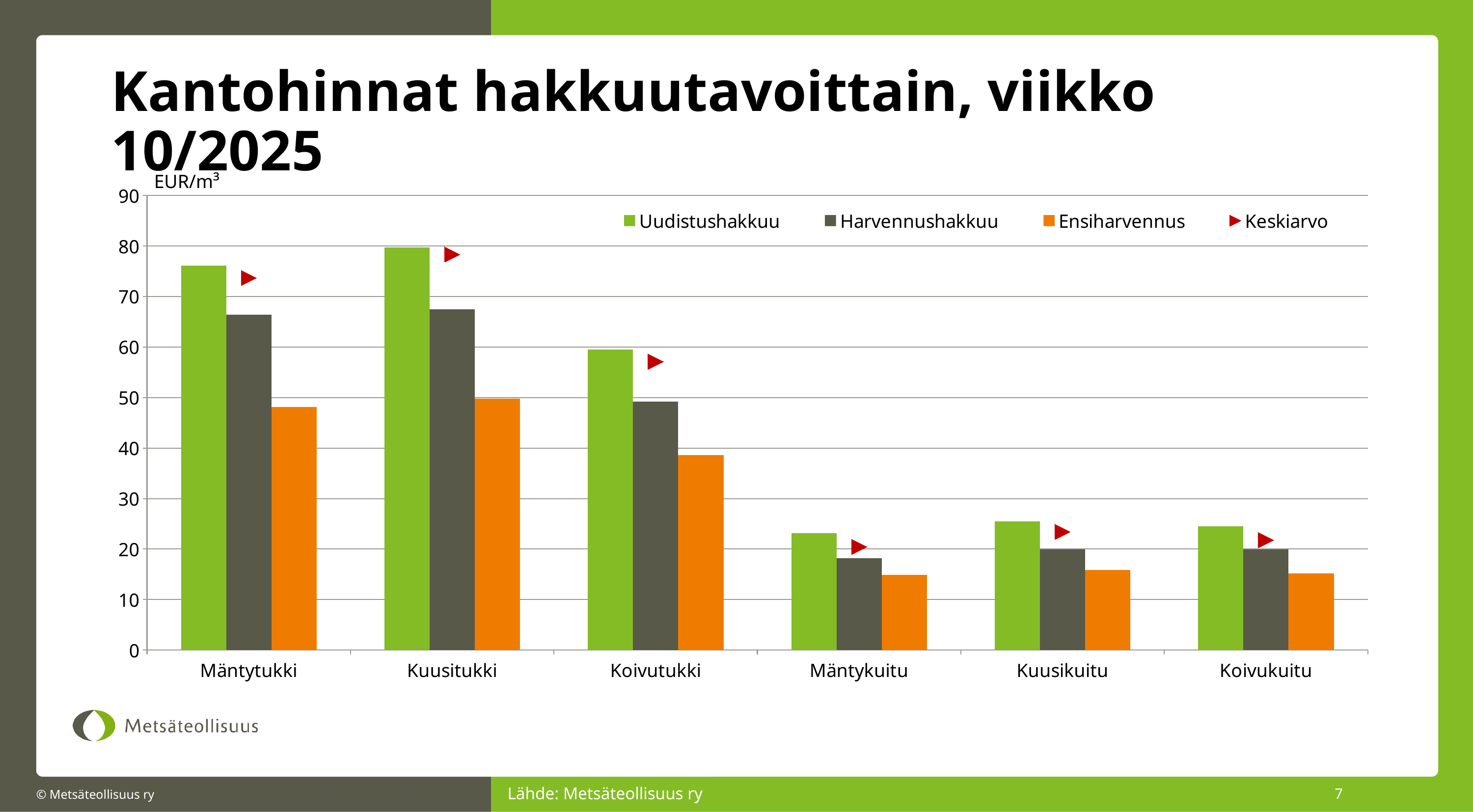
Is the Uudistushakkuu value for Mäntytukki greater or less than 70? greater Is the Harvennushakkuu value for Kuusitukki greater or less than 60? greater Which is larger, the Ensiharvennus value for Kuusitukki or the Ensiharvennus value for Mäntytukki? Ensiharvennus value for Kuusitukki What unit is shown above the y axis? EUR/m³ How many categories are shown on the x axis? 6 What kind of chart is shown on the slide? bar chart Which category has the lowest Uudistushakkuu value? Mäntykuitu How many series does the legend list? 4 Which category has the highest Uudistushakkuu value? Kuusitukki Is the Ensiharvennus value for Koivutukki greater or less than 40? less Which is larger, the Uudistushakkuu value for Koivutukki or the Harvennushakkuu value for Mäntytukki? Harvennushakkuu value for Mäntytukki